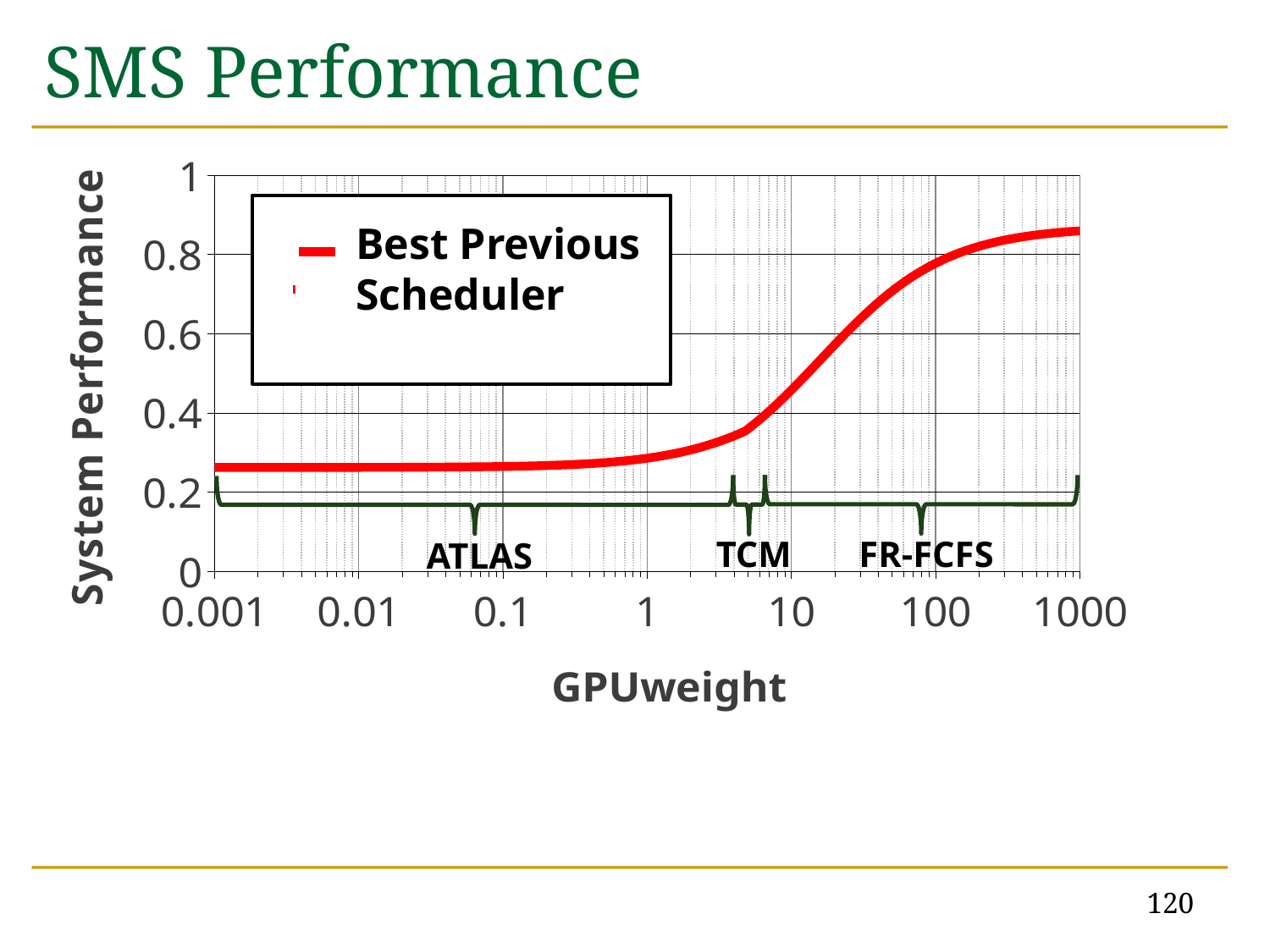
What kind of chart is shown on the slide? line chart Is the System Performance of the Best Previous Scheduler at GPUweight 0.001 greater or less than 0.2? greater Does the System Performance of the Best Previous Scheduler rise or fall as GPUweight increases along the x axis? rise Is the System Performance of the Best Previous Scheduler at GPUweight 1000 greater or less than 0.8? greater What is the title of the slide containing the chart? SMS Performance Is the System Performance of the Best Previous Scheduler at GPUweight 10 greater or less than 0.6? less What is the name of the series shown in the legend? Best Previous Scheduler Which has the higher System Performance for the Best Previous Scheduler: GPUweight 0.01 or GPUweight 100? GPUweight 100 How many labeled tick values are shown on the GPUweight x axis? 7 How many series does the legend list? 1 What is the label of the y axis? System Performance